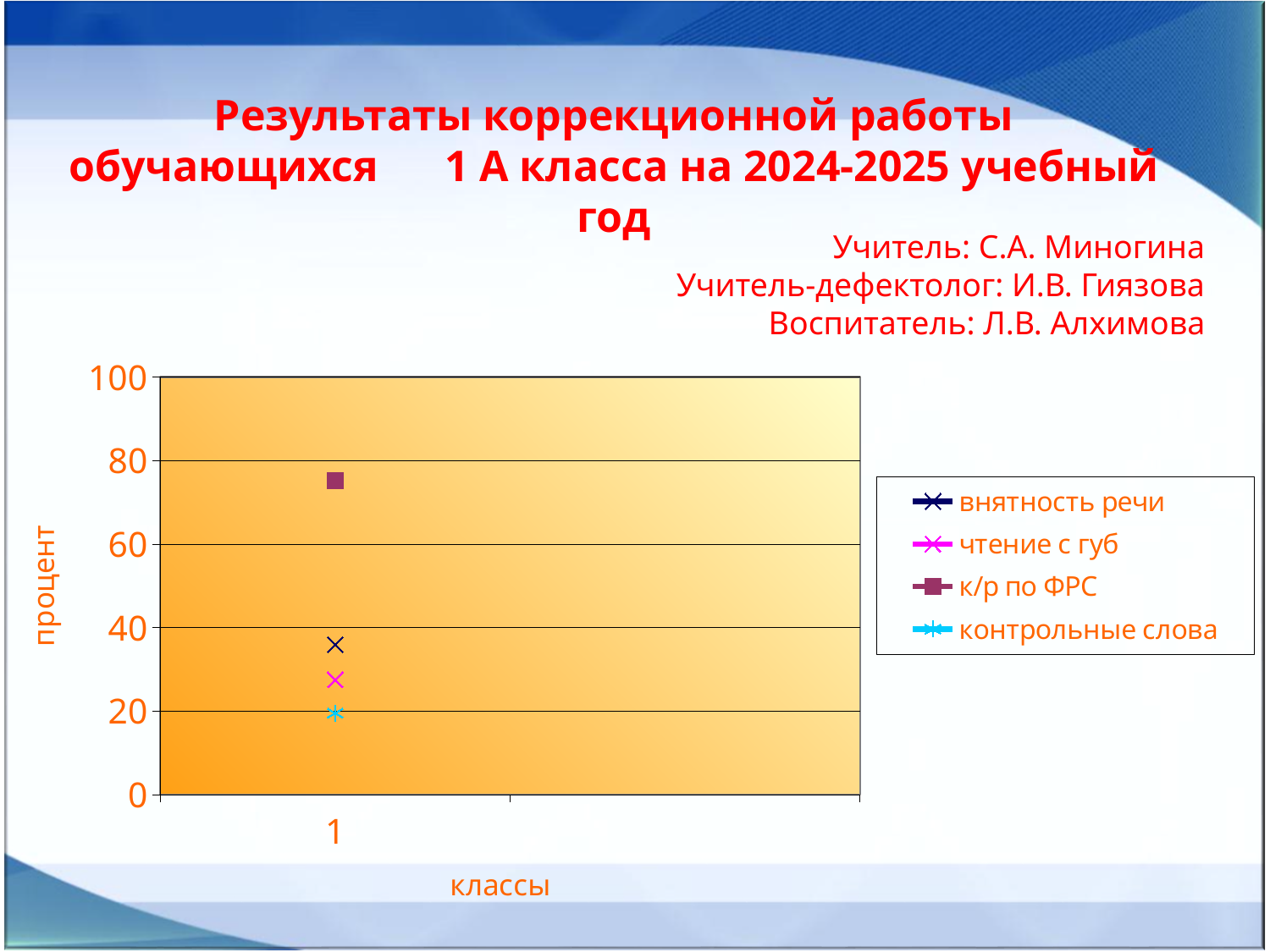
Is the value for внятность речи greater or less than 40? less Which series has the lowest value in the chart? контрольные слова What is the title of the vertical axis of the chart? процент What is the title of the horizontal axis of the chart? классы Is the value for к/р по ФРС greater or less than 60? greater Which series has the highest value in the chart? к/р по ФРС Is the value for контрольные слова greater or less than 40? less How many series does the chart legend list? 4 How many categories are shown on the x axis of the chart? 1 Which is larger, the value for внятность речи or the value for чтение с губ? внятность речи